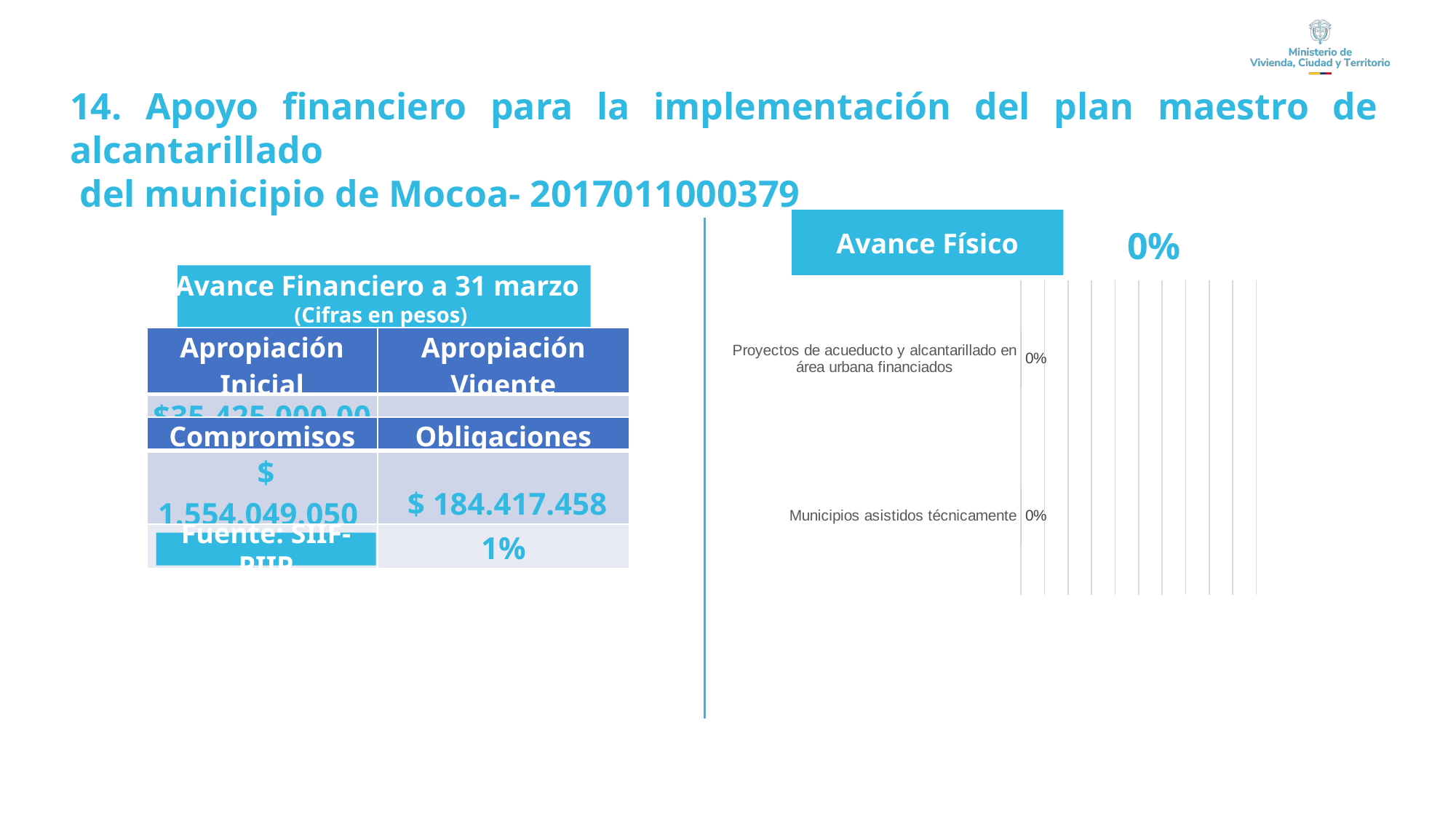
What is the difference between the values for 'Proyectos de acueducto y alcantarillado en área urbana financiados' and 'Municipios asistidos técnicamente' in the Avance Físico chart? 0% What overall percentage is displayed next to the Avance Físico chart title? 0% What is the title of the chart on the right side of the slide? Avance Físico What kind of chart is the Avance Físico chart? bar chart What is the value for 'Proyectos de acueducto y alcantarillado en área urbana financiados' in the Avance Físico chart? 0% Is the value for 'Municipios asistidos técnicamente' in the Avance Físico chart greater than 0%? No How many categories does the Avance Físico chart show? 2 What is the value for 'Municipios asistidos técnicamente' in the Avance Físico chart? 0%